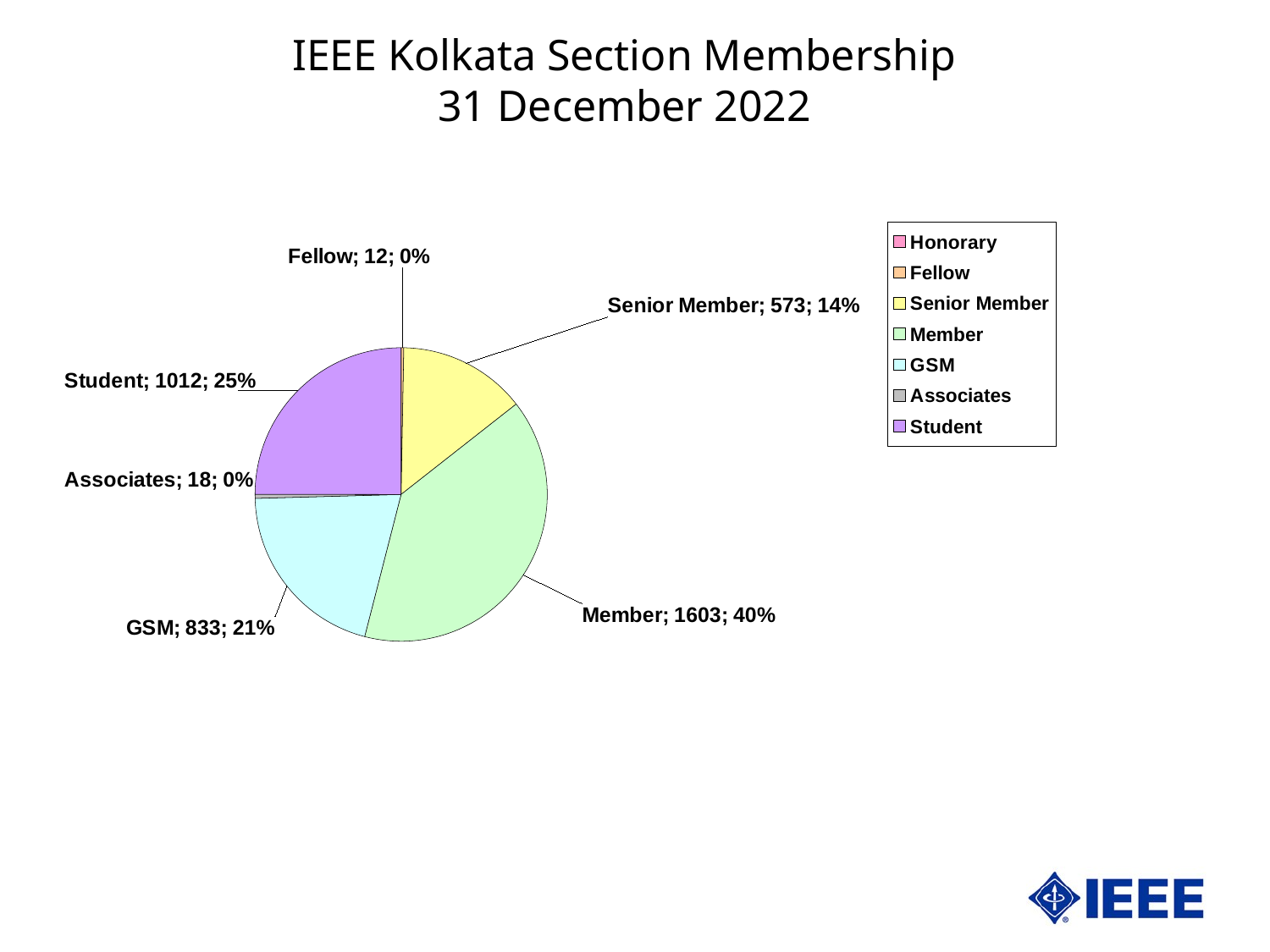
Which is larger, the GSM count or the Senior Member count? GSM Which category has the largest slice of the pie? Member How many members are in the Member category? 1603 What is the value shown for Associates? 18 What is the difference between the Member count and the Student count? 591 Which is larger, the Fellow count or the Associates count? Associates What is the difference between the GSM count and the Senior Member count? 260 What is the value shown for Senior Member? 573 What percentage of the pie is the GSM slice? 21% What kind of chart is shown on the slide? Pie chart How many entries does the legend list? 7 What share of the pie does the Student slice represent? 25%